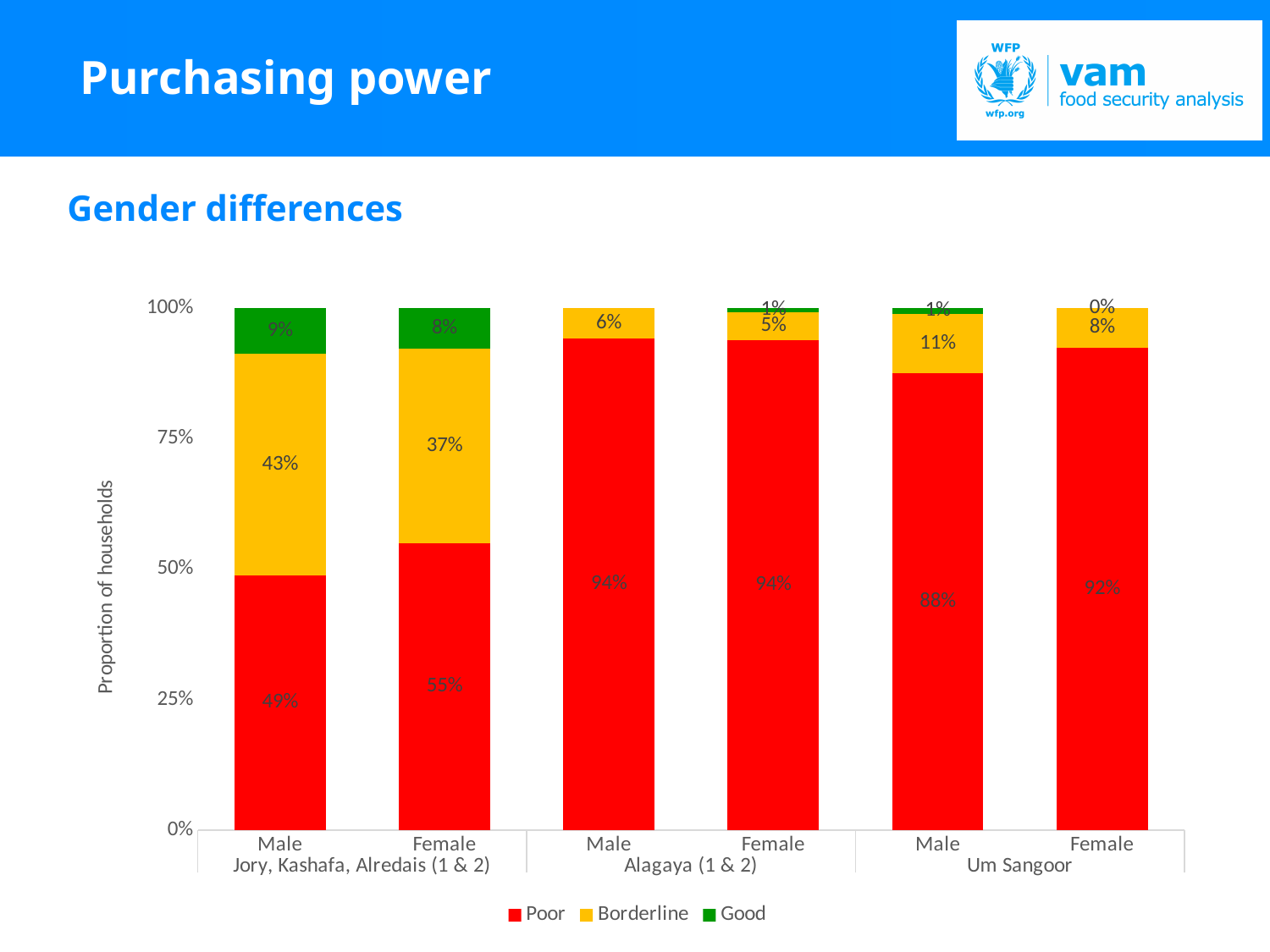
Which bar has the lowest Poor share? Male, Jory, Kashafa, Alredais (1 & 2) Is the Poor share for Male households in Um Sangoor greater or less than 75%? greater What is the Borderline share for Female households in Jory, Kashafa, Alredais (1 & 2)? 37% How many series does the legend list? 3 Which is larger: the Poor share for Male or Female households in Um Sangoor? Female Which bar has the highest Poor share? Male and Female in Alagaya (1 & 2), both 94% What is the Borderline share for Male households in Um Sangoor? 11% What is the difference between the Poor share for Female and Male households in Jory, Kashafa, Alredais (1 & 2)? 6 percentage points What type of chart is shown on the slide? Stacked bar chart How many bars are plotted in the chart? 6 What is the Poor share for Male households in Jory, Kashafa, Alredais (1 & 2)? 49% What is the Good share for Female households in Um Sangoor? 0%